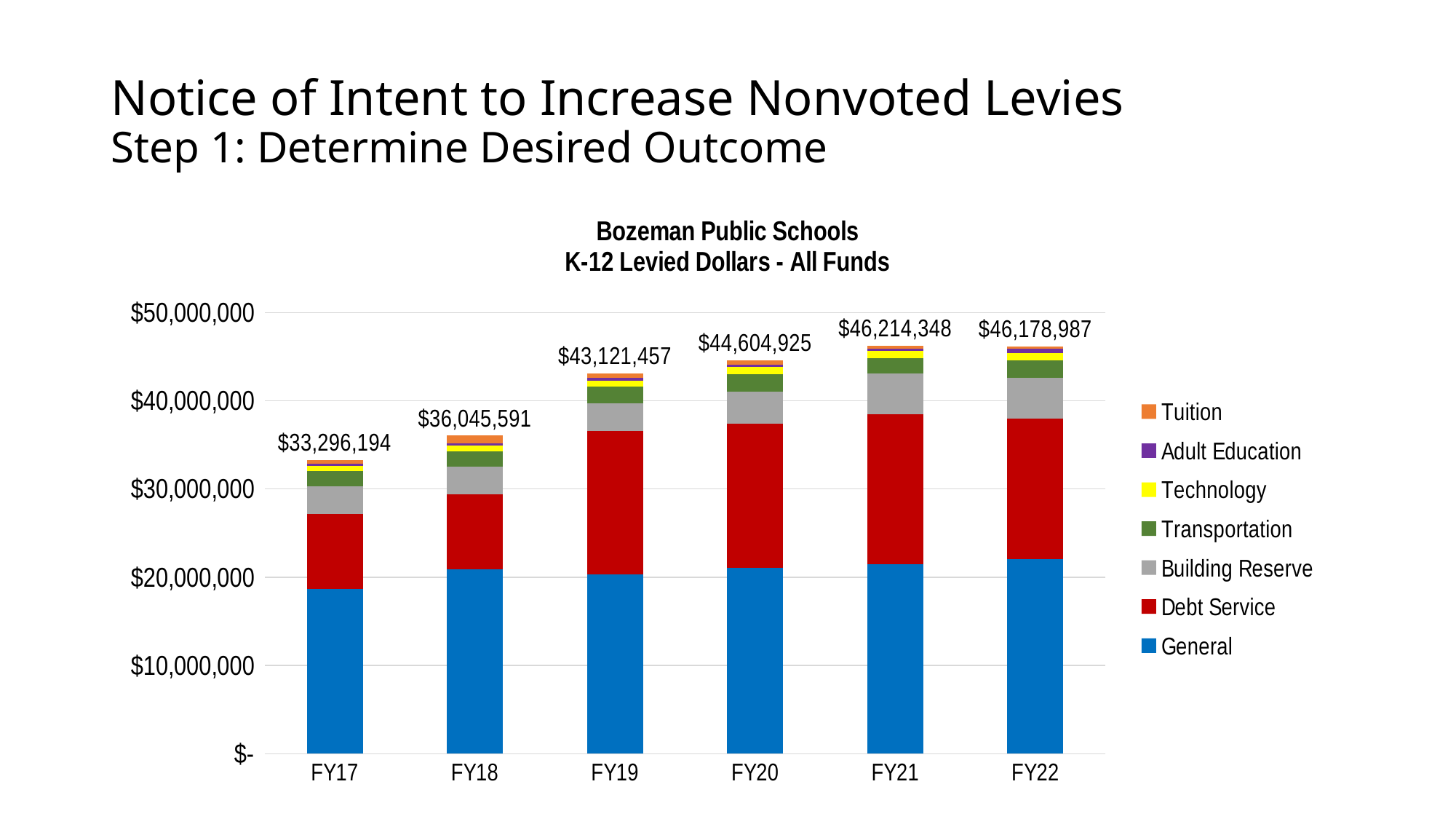
What kind of chart is shown? Stacked bar chart What is the difference between the FY21 total and the FY20 total? $1,609,423 Which fiscal year has the highest total levied dollars? FY21 What is the total levied dollars for FY19? $43,121,457 How many fiscal years are shown on the x axis? 6 Is the General fund value for FY17 greater or less than $20,000,000? less What is the total levied dollars for FY17? $33,296,194 What is the difference between the FY22 total and the FY17 total? $12,882,793 How many series does the legend list? 7 Which fiscal year has the lowest total levied dollars? FY17 Which total is larger, FY18 or FY19? FY19 Do the total levied dollars rise or fall from FY17 to FY21? rise